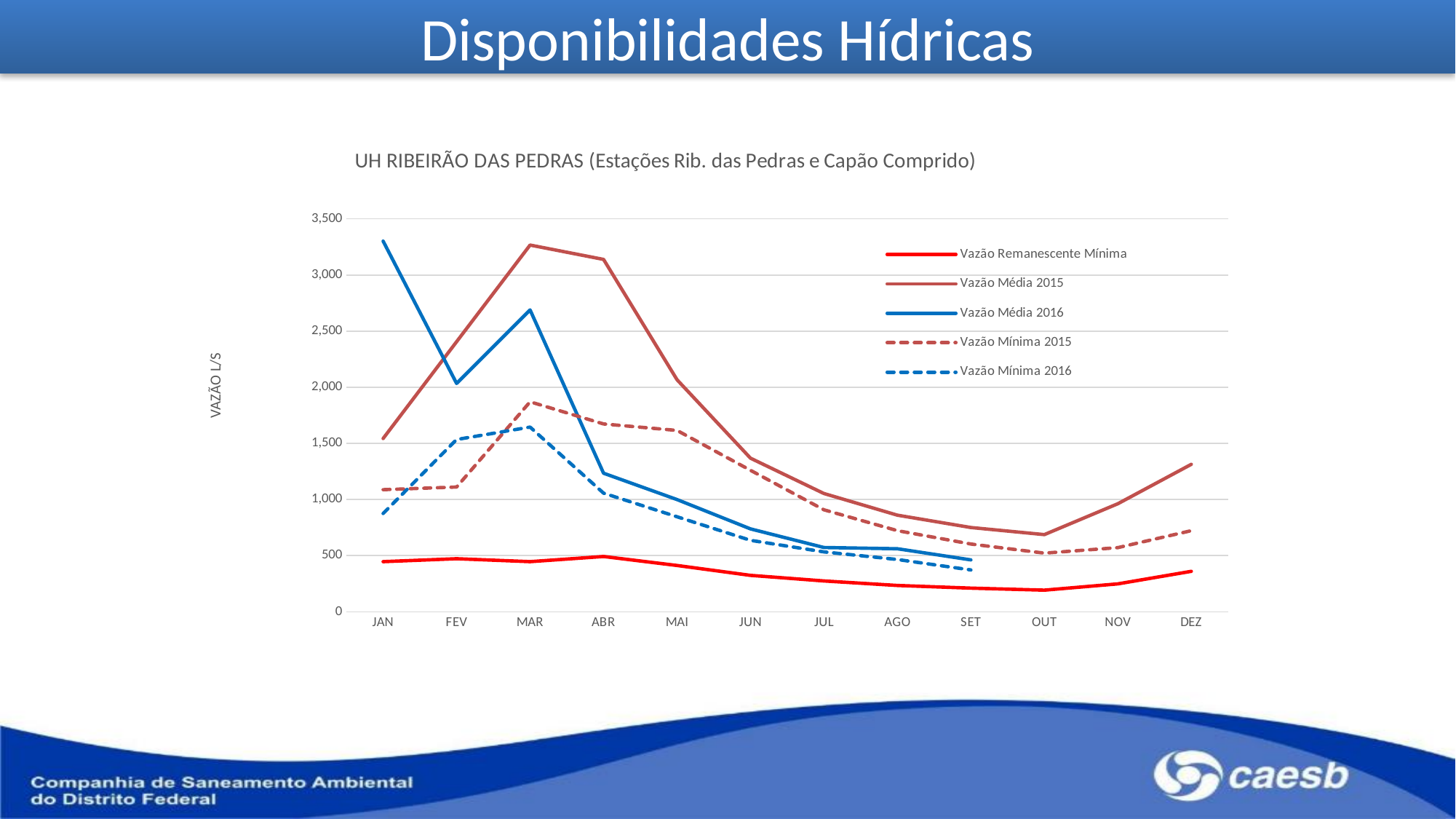
How many months are shown along the x axis? 12 Is the value for Vazão Média 2016 in JAN greater or less than 3,000? greater In which month is Vazão Média 2015 at its lowest? OUT Is the value for Vazão Remanescente Mínima in OUT greater or less than 500? less Does Vazão Média 2015 rise or fall from MAR to OUT? fall In FEV, which is higher: Vazão Média 2015 or Vazão Média 2016? Vazão Média 2015 How many series does the legend list? 5 In which month does Vazão Média 2015 reach its highest value? MAR In which month does Vazão Média 2016 reach its highest value? JAN Is the value for Vazão Mínima 2015 in MAR greater or less than 1,500? greater What is the label on the vertical axis? VAZÃO L/S What kind of chart is shown on the slide? line chart